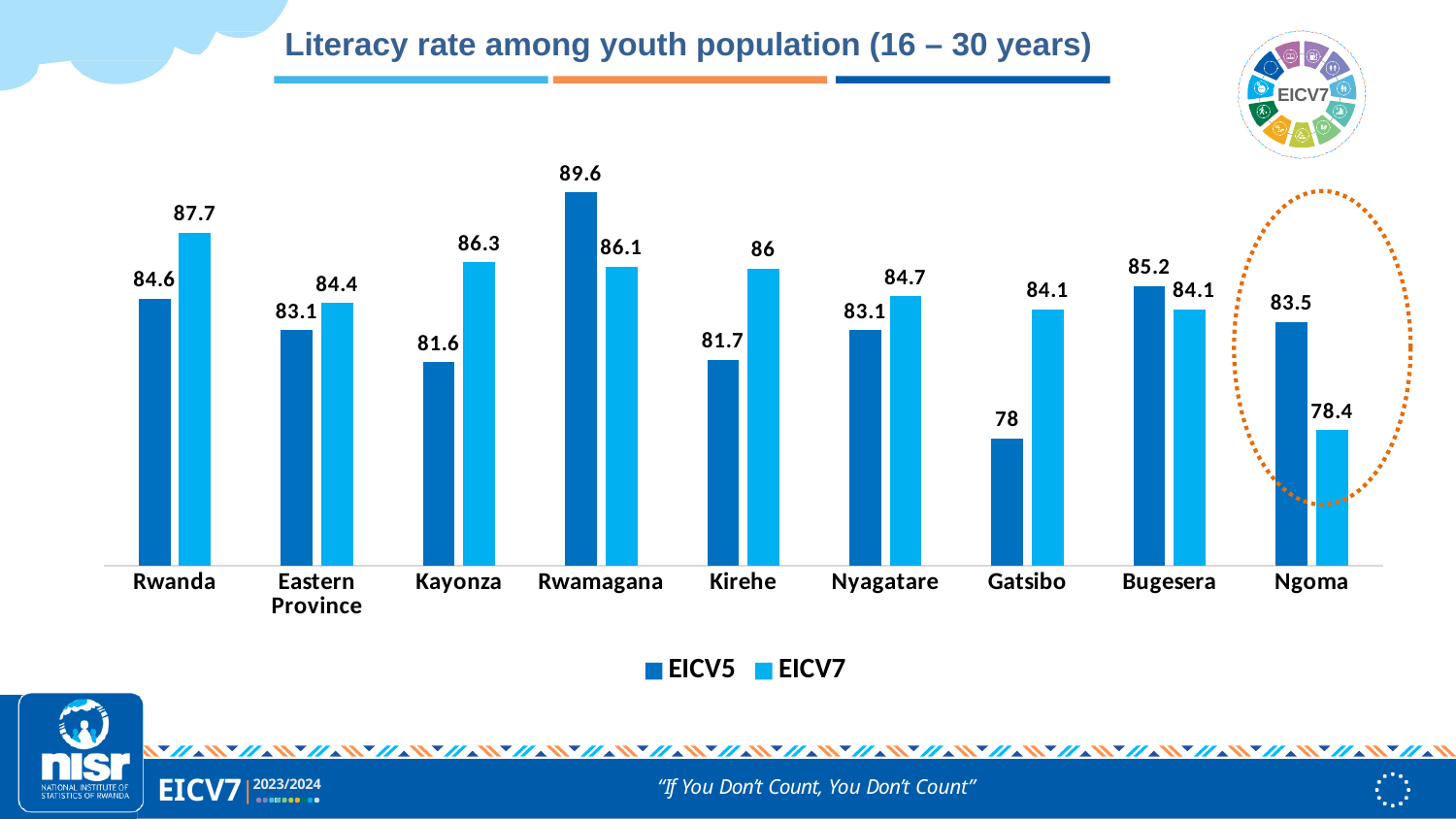
What is the EICV5 literacy rate for Kirehe? 81.7 How many categories are shown on the x axis? 9 What is the title of the chart? Literacy rate among youth population (16 – 30 years) Which category has the highest EICV5 value? Rwamagana What is the EICV7 literacy rate for Ngoma? 78.4 How many series does the legend list? 2 Which is larger for Bugesera, the EICV5 value or the EICV7 value? EICV5 What kind of chart is shown on the slide? Bar chart What is the difference between the EICV7 and EICV5 values for Gatsibo? 6.1 What is the EICV7 literacy rate for Rwanda? 87.7 Which category has the lowest EICV7 value? Ngoma What is the EICV5 literacy rate for Gatsibo? 78